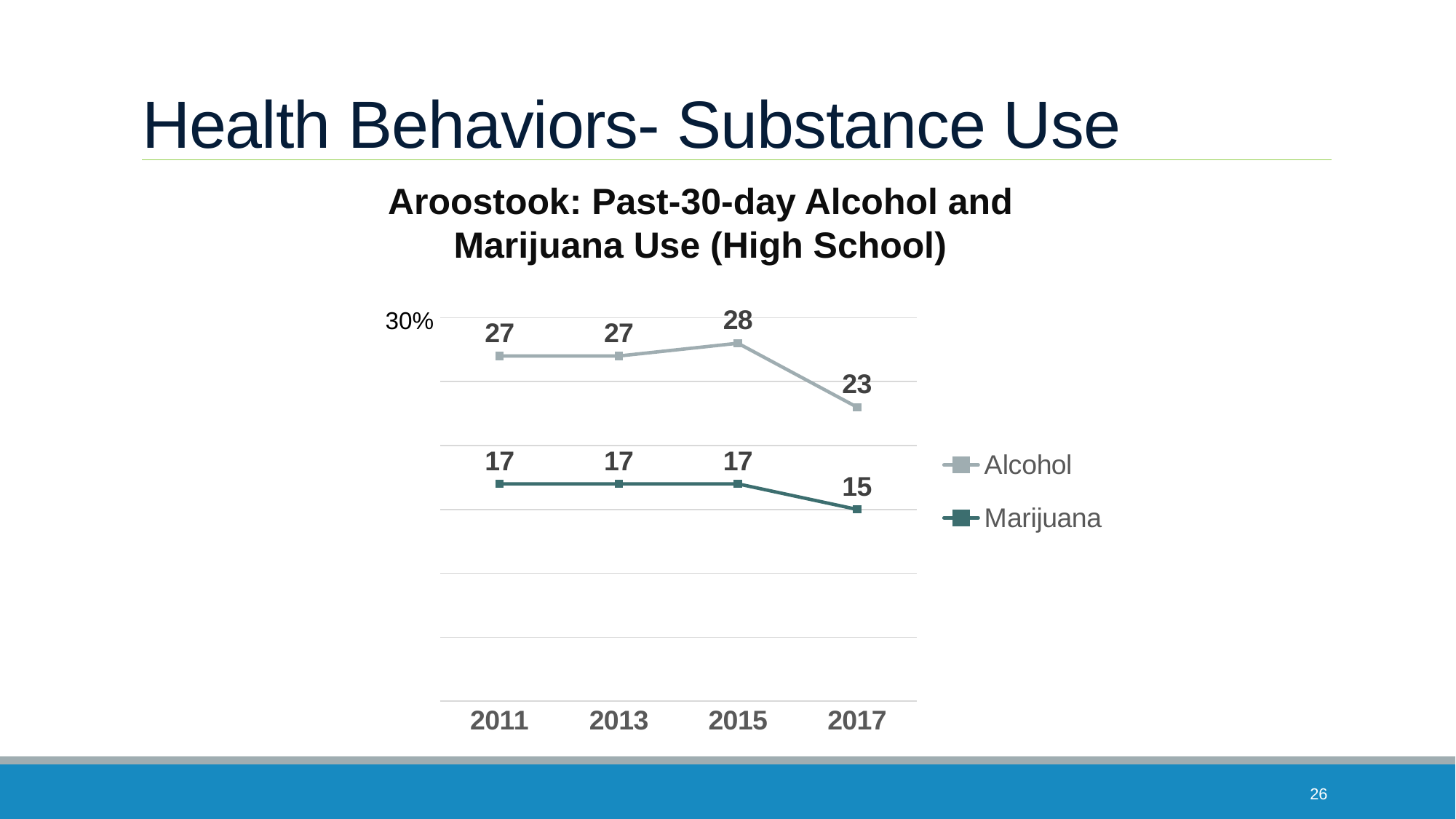
In which year is the Marijuana value lowest? 2017 What is the Marijuana value for 2017? 15 Does the Alcohol series rise or fall from 2015 to 2017? Fall By how much did the Alcohol value change from 2015 to 2017? 5 How many years are shown on the x axis? 4 How many series does the legend list? 2 What kind of chart is shown on the slide? Line chart Which series has the larger value in 2013, Alcohol or Marijuana? Alcohol What is the difference between the Alcohol and Marijuana values in 2017? 8 In which year is the Alcohol value highest? 2015 What is the Alcohol value for 2015? 28 What is the Alcohol value for 2011? 27